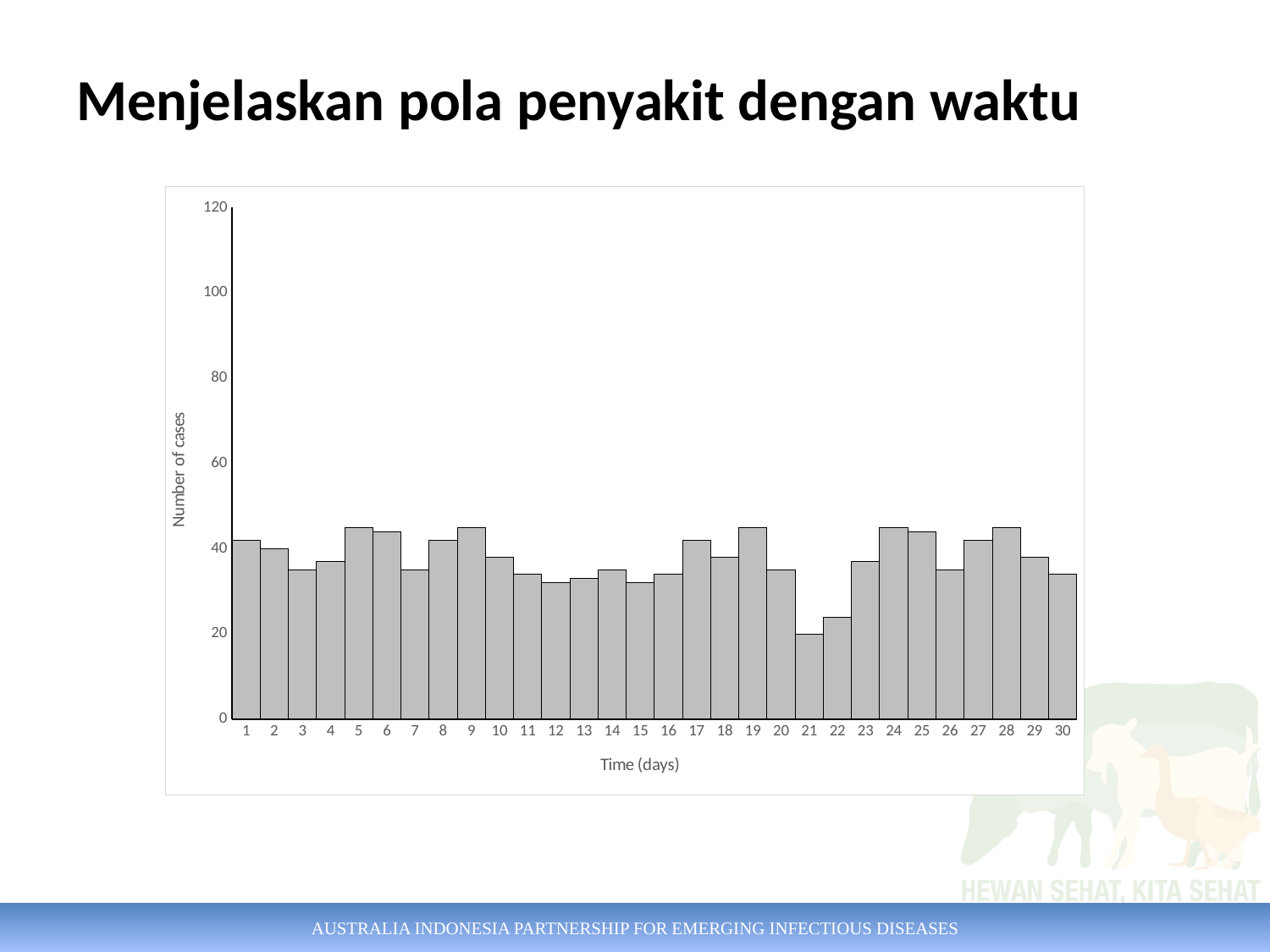
Is the number of cases on day 21 greater or less than 40? less Is the number of cases on day 5 greater or less than 40? greater What is the label of the y axis? Number of cases What kind of chart is shown on the slide? bar chart Which day has more cases, day 5 or day 21? day 5 Is the number of cases on day 22 greater or less than 40? less What is the label of the x axis? Time (days) How many days (bars) are plotted on the x axis? 30 Do the number of cases rise or fall from day 20 to day 21? fall Which day has more cases, day 22 or day 24? day 24 Which day has the lowest number of cases? 21